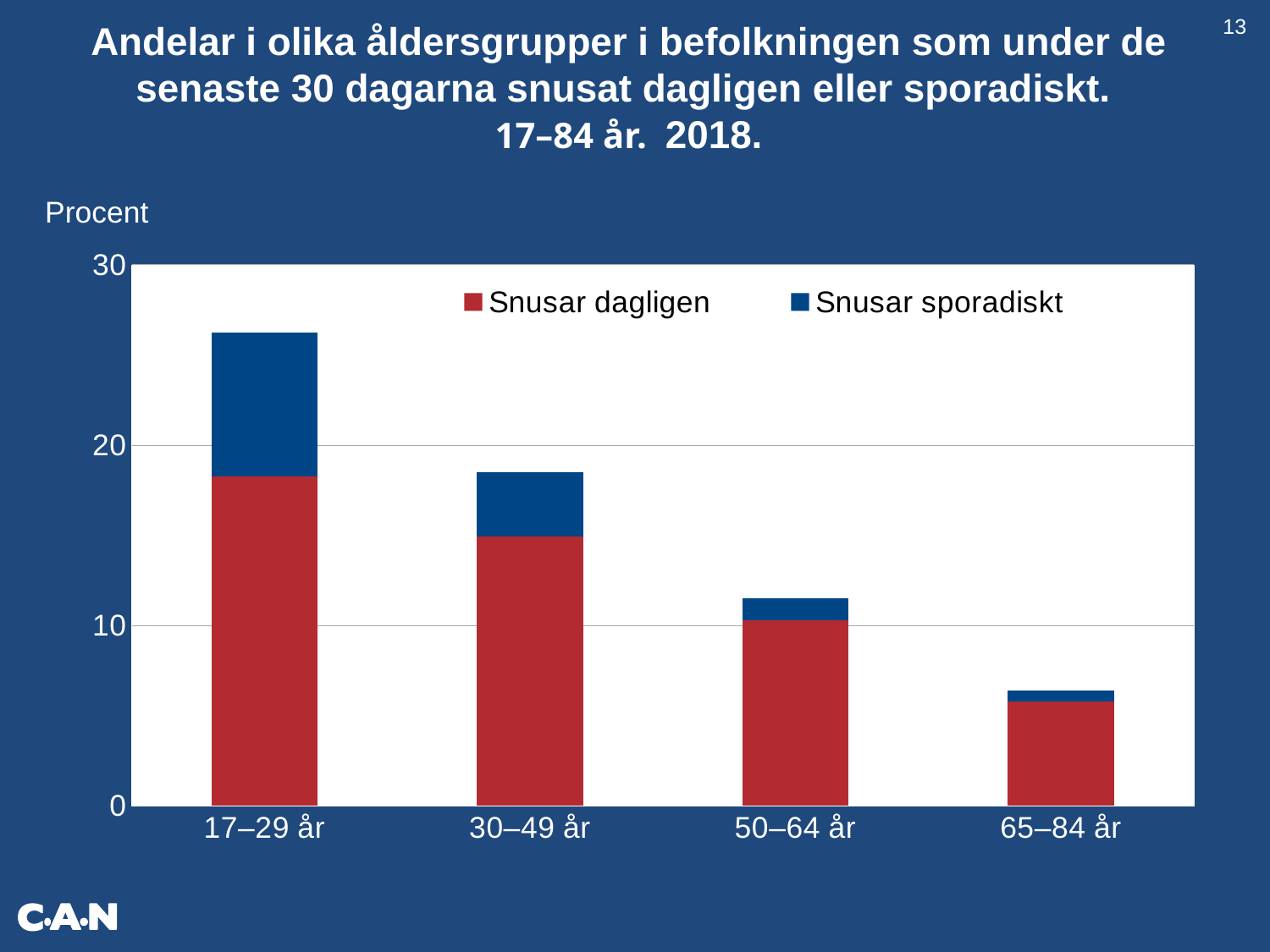
Is the total value for 17–29 år greater or less than 20? greater Is the total value for 65–84 år greater or less than 10? less Which age group has the lowest total bar? 65–84 år Is the total value for 50–64 år greater or less than 10? greater What kind of chart is shown on the slide? Bar chart How many age groups are shown on the x axis? 4 How many series does the legend list? 2 Which age group has the highest total bar? 17–29 år Which colour represents Snusar dagligen in the chart? Red Which is larger, the Snusar dagligen value for 17–29 år or for 30–49 år? 17–29 år Do the total bar heights rise or fall as age group increases along the x axis? fall